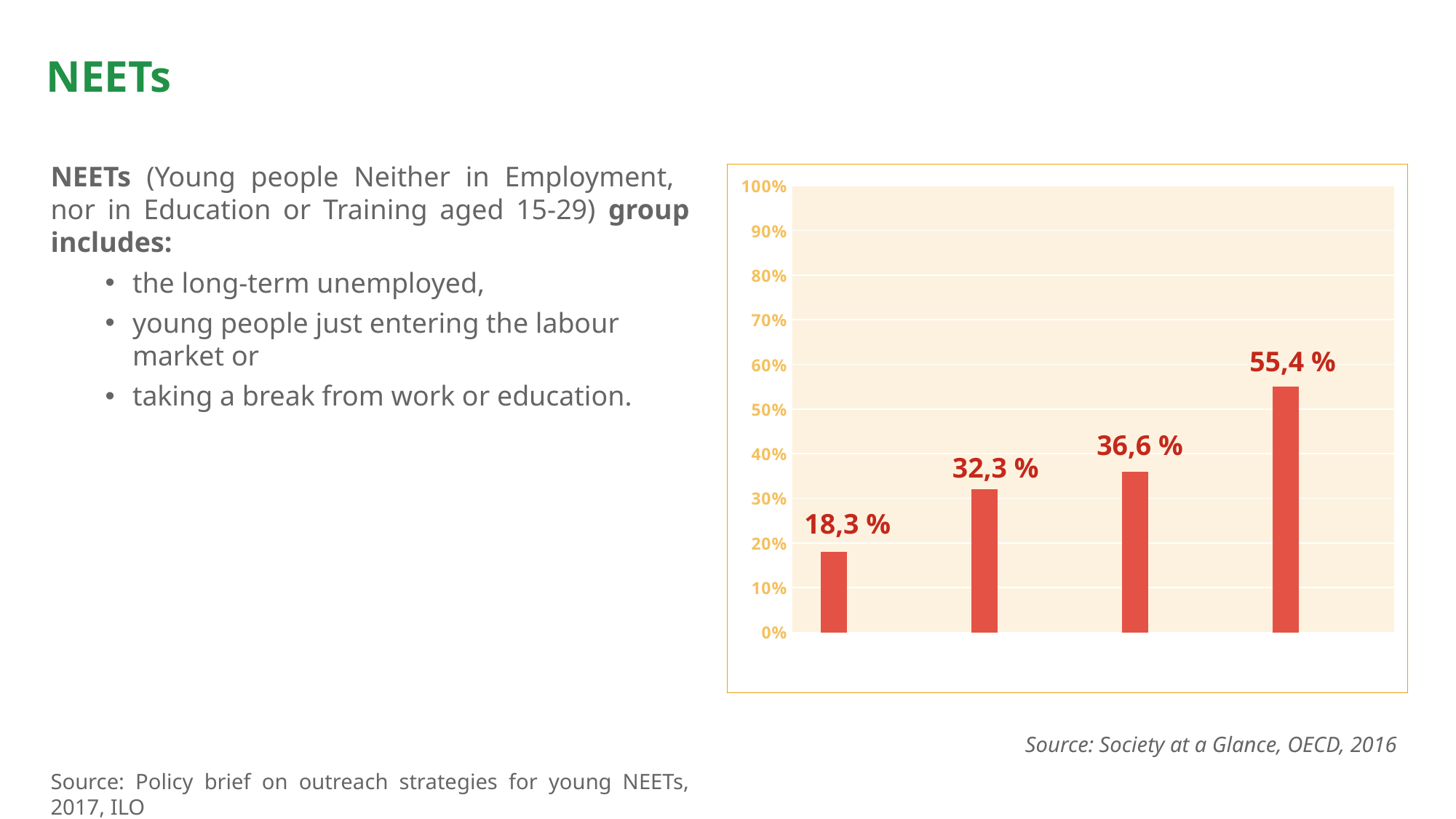
What is the highest value labelled in the chart? 55,4 % What is the value shown on the fourth (rightmost) bar of the chart? 55,4 % What is the value shown on the second bar from the left in the chart? 32,3 % What is the maximum value shown on the chart's vertical axis? 100% What is the difference between the rightmost bar (55,4 %) and the leftmost bar (18,3 %) in the chart? 37,1 % How many bars are plotted in the chart? 4 What is the value shown on the third bar from the left in the chart? 36,6 % What is the value shown on the first (leftmost) bar of the chart? 18,3 % What is the lowest value labelled in the chart? 18,3 % What type of chart is shown on the slide? bar chart Which is larger in the chart: the second bar from the left or the third bar from the left? the third bar from the left Do the bar values rise or fall from left to right across the chart? rise